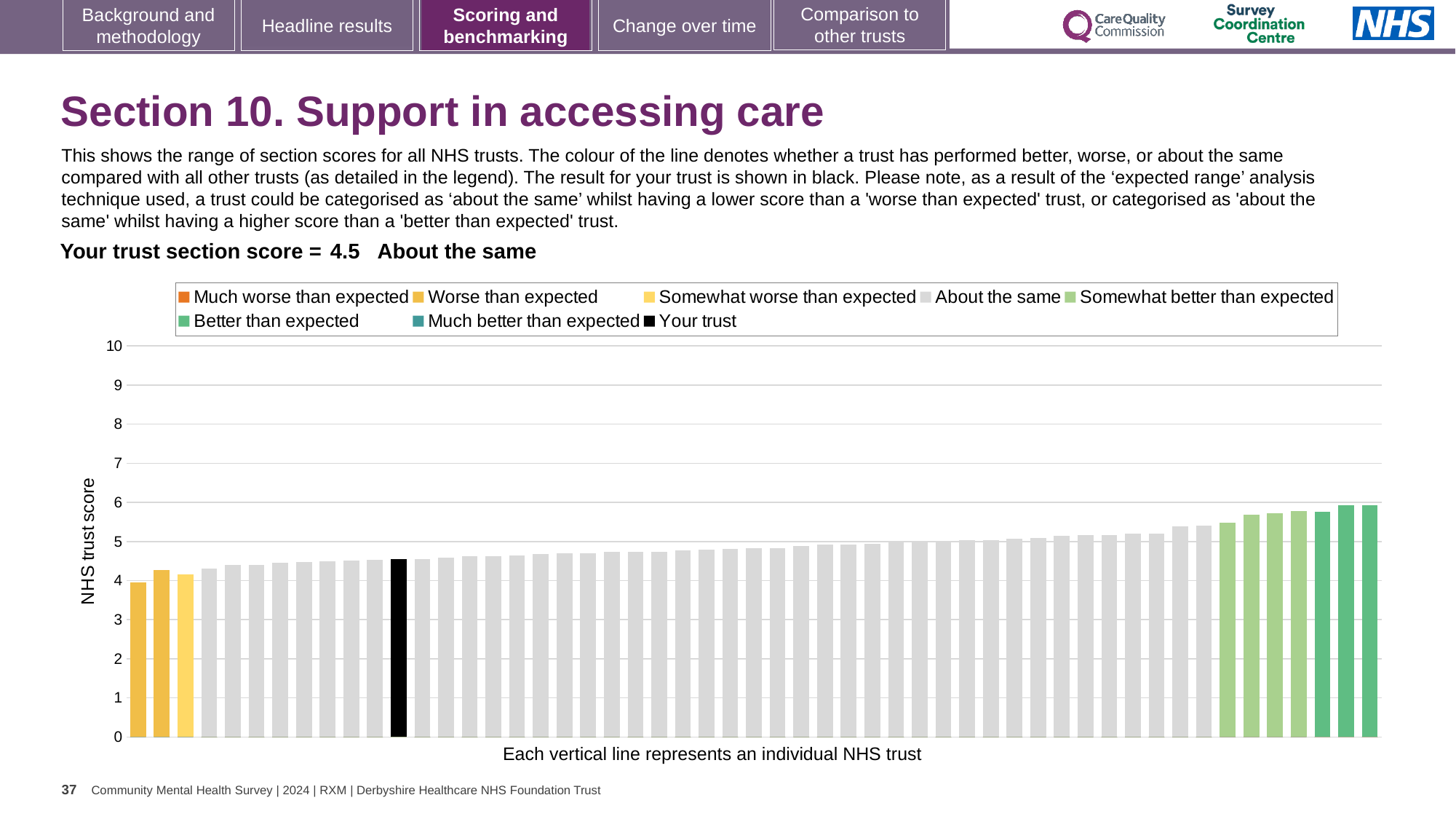
How many entries does the chart legend list? 8 What kind of chart is shown on the slide? bar chart Is the value of the lowest bar greater or less than 5? less Do the bar values rise or fall from left to right along the x axis? rise What is the section score for your trust? 4.5 Is the value for your trust (the black bar) greater or less than 4? greater Is the value of the highest bar greater or less than 5? greater What is the label on the vertical axis of the chart? NHS trust score How many bars are coloured in the 'Worse than expected' colour? 2 Which category is your trust placed in according to the slide? About the same